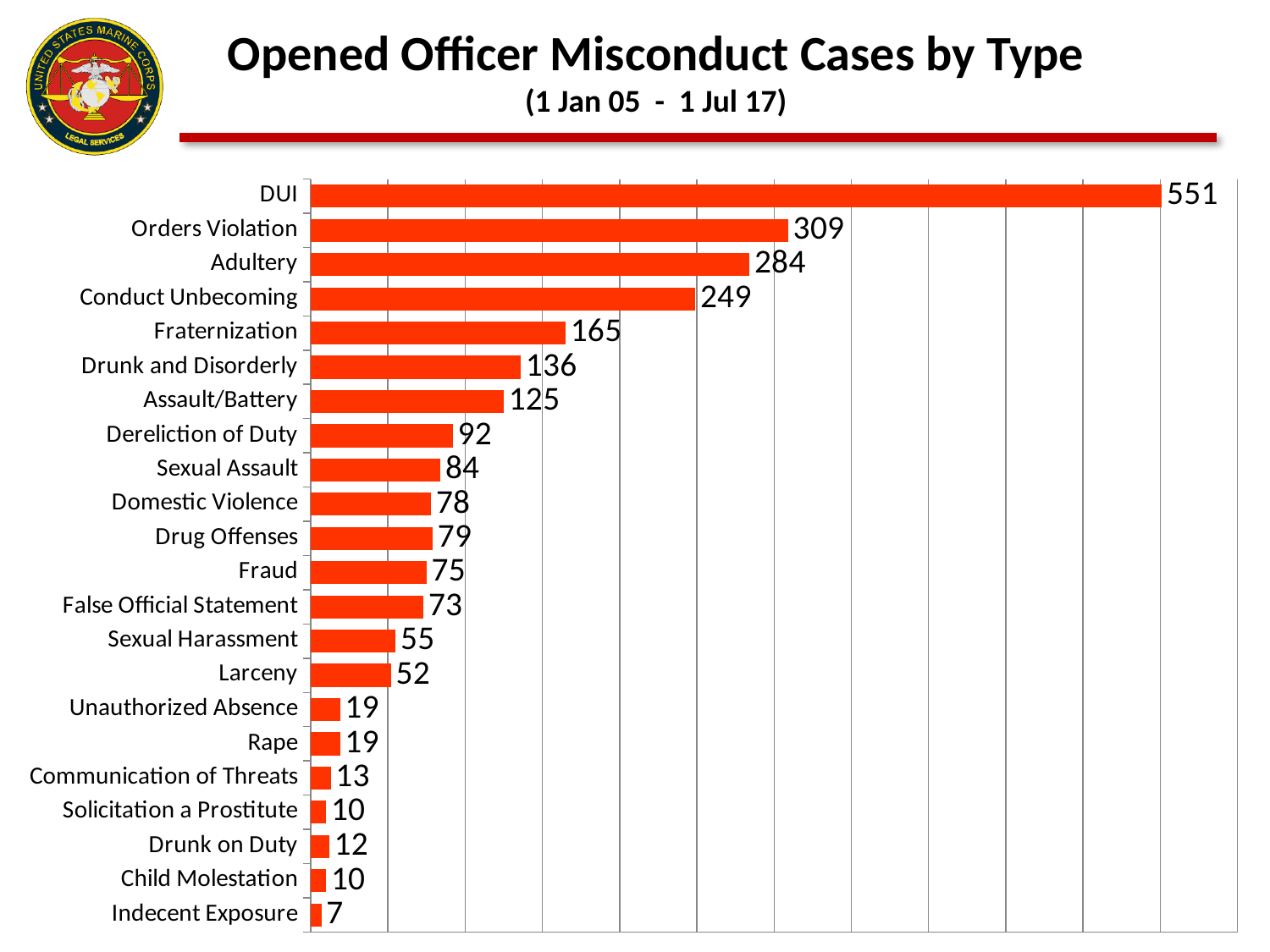
Which has more cases, Larceny or Unauthorized Absence? Larceny What date range is given in the chart's subtitle? 1 Jan 05 - 1 Jul 17 How many case types are shown in the chart? 22 How many cases are shown for Fraternization? 165 What is the value for Sexual Harassment? 55 What kind of chart is shown on the slide? Bar chart How many more DUI cases are there than Conduct Unbecoming cases? 302 Which case type has the lowest number of opened cases? Indecent Exposure What is the number of opened officer misconduct cases for DUI? 551 Which case type has the highest number of opened cases? DUI What is the difference between the number of Orders Violation cases and Adultery cases? 25 Which has more cases, Drunk and Disorderly or Assault/Battery? Drunk and Disorderly